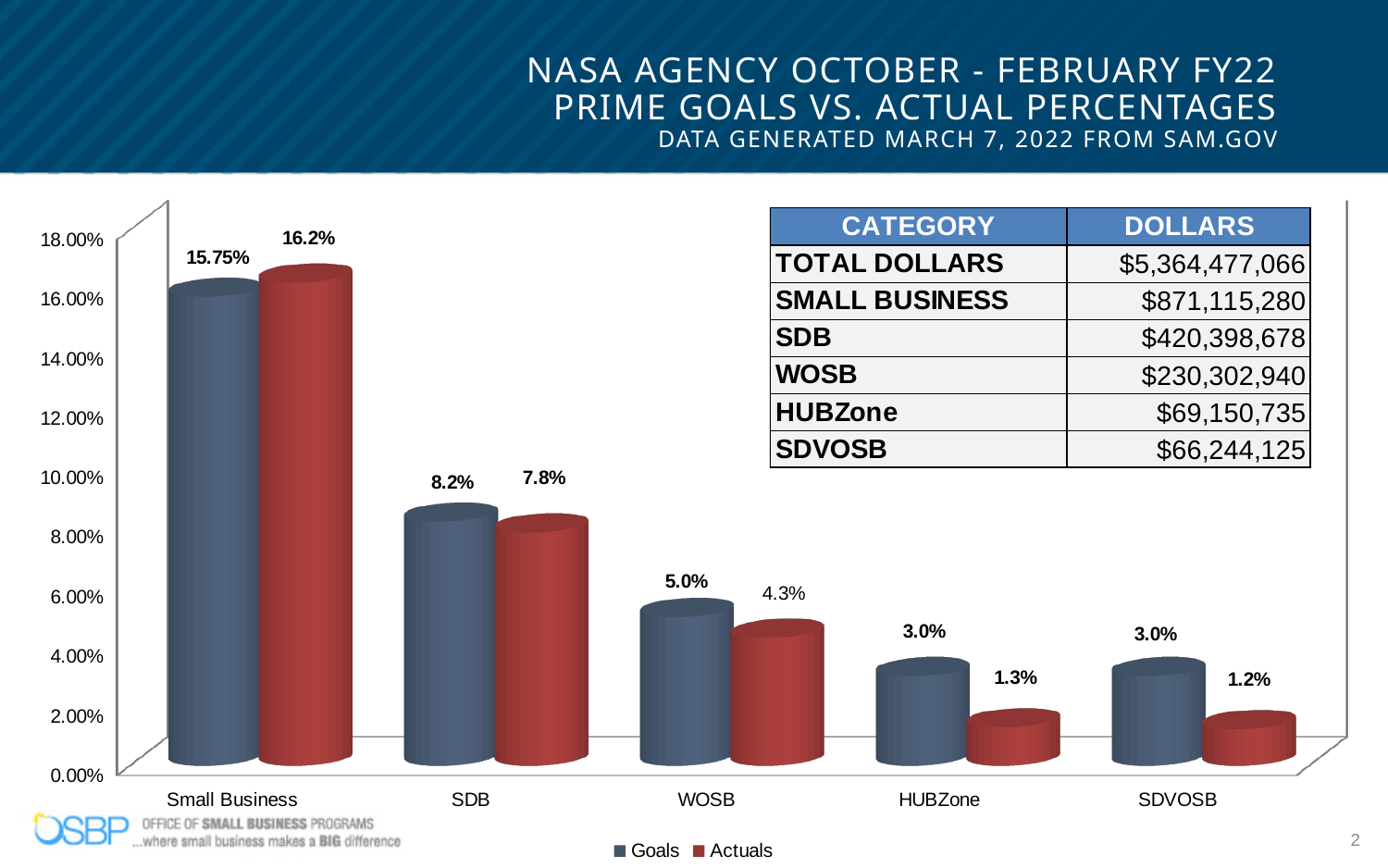
How many series does the legend list? 2 Which is larger for Small Business, the Goals value or the Actuals value? Actuals What is the Goals value for WOSB? 5.0% What is the Actuals value for HUBZone? 1.3% Which category has the lowest Actuals value? SDVOSB What is the Actuals value for SDB? 7.8% Which category has the highest Actuals value? Small Business What is the difference between the Goals and Actuals values for HUBZone? 1.7% What is the Goals value for Small Business? 15.75% How many categories are shown on the x axis? 5 Is the Actuals value for WOSB greater or less than 6.00%? less What kind of chart is shown on the slide? bar chart